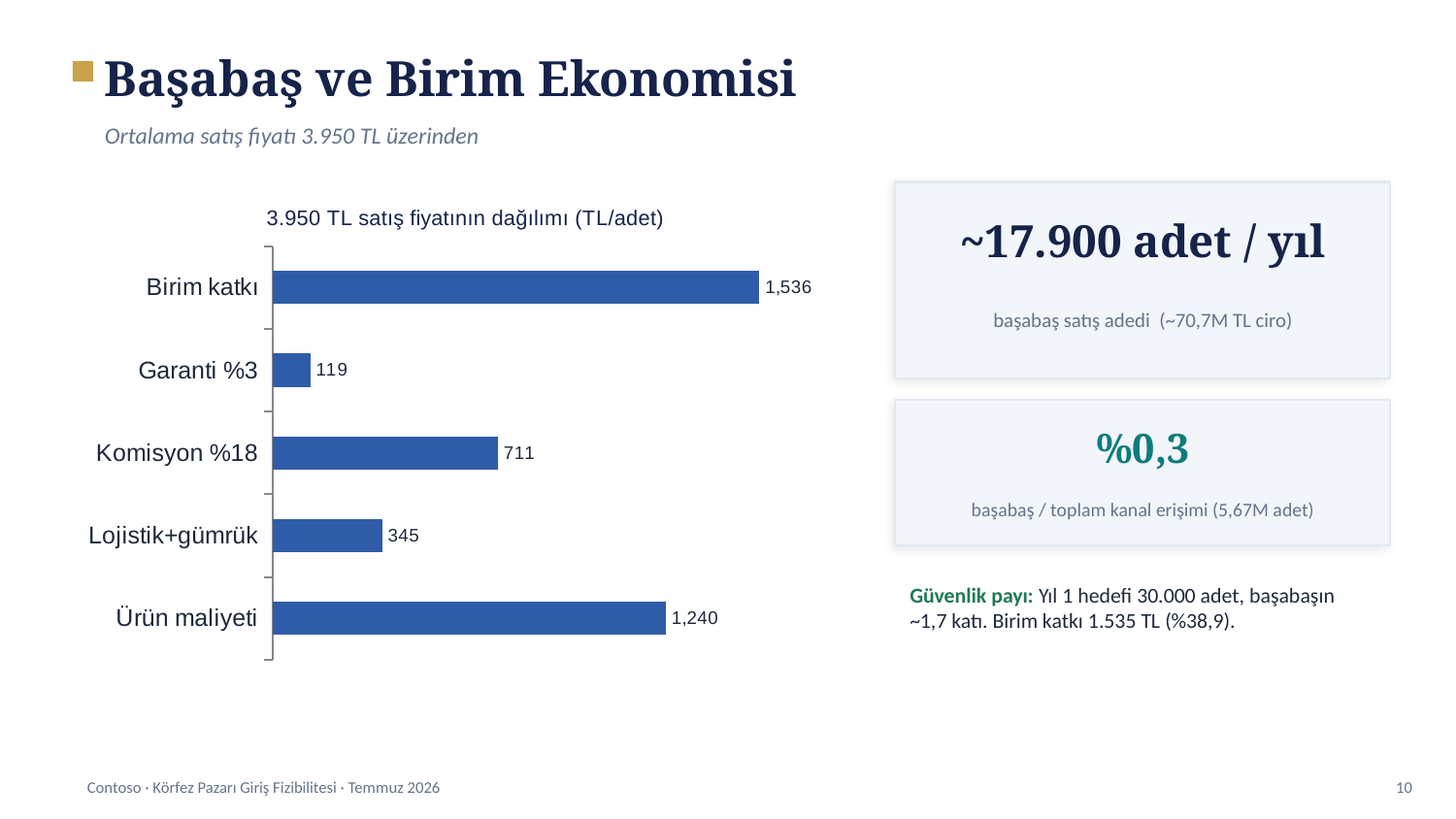
Which is larger, the value for Komisyon %18 or the value for Lojistik+gümrük? Komisyon %18 What is the difference between the values for Birim katkı and Ürün maliyeti? 296 What is the difference between the values for Komisyon %18 and Lojistik+gümrük? 366 What is the value for Birim katkı? 1,536 Which category has the lowest value? Garanti %3 What is the value for Komisyon %18? 711 What kind of chart is shown on the slide? Bar chart How many categories are shown in the chart? 5 What is the value for Lojistik+gümrük? 345 Which category has the highest value? Birim katkı What is the value for Ürün maliyeti? 1,240 What is the title of the chart? 3.950 TL satış fiyatının dağılımı (TL/adet)